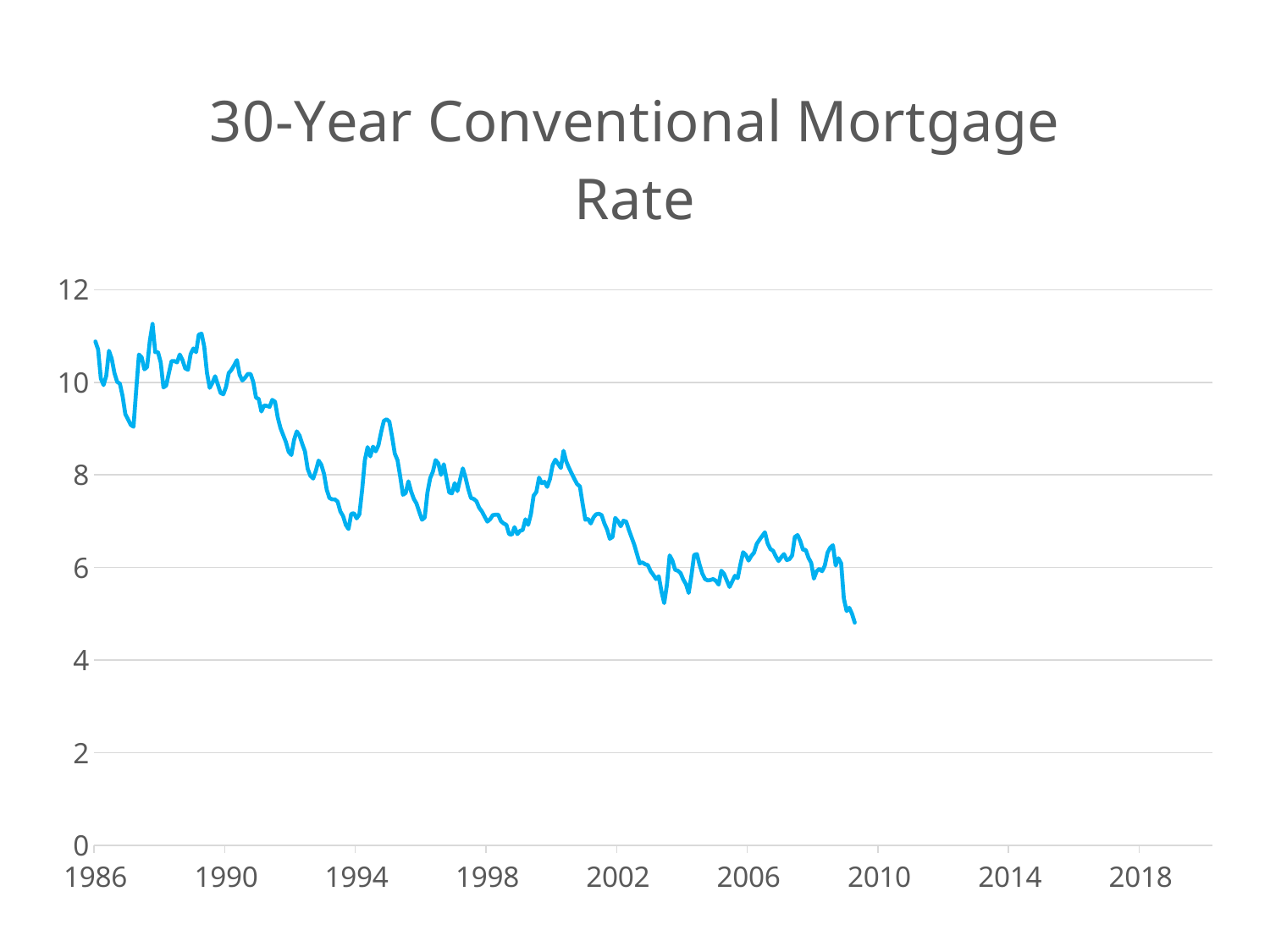
Is the value in 1990 larger than the value in 2006? yes Is the value in 1998 greater or less than 8? less Is the highest value reached by the line greater or less than 10? greater Is the value in 2002 greater or less than 6? greater Overall, do the values rise or fall from 1986 to the end of the line? fall What is the highest value shown on the vertical axis? 12 What is the title of the chart? 30-Year Conventional Mortgage Rate What kind of chart is shown on the slide? line chart